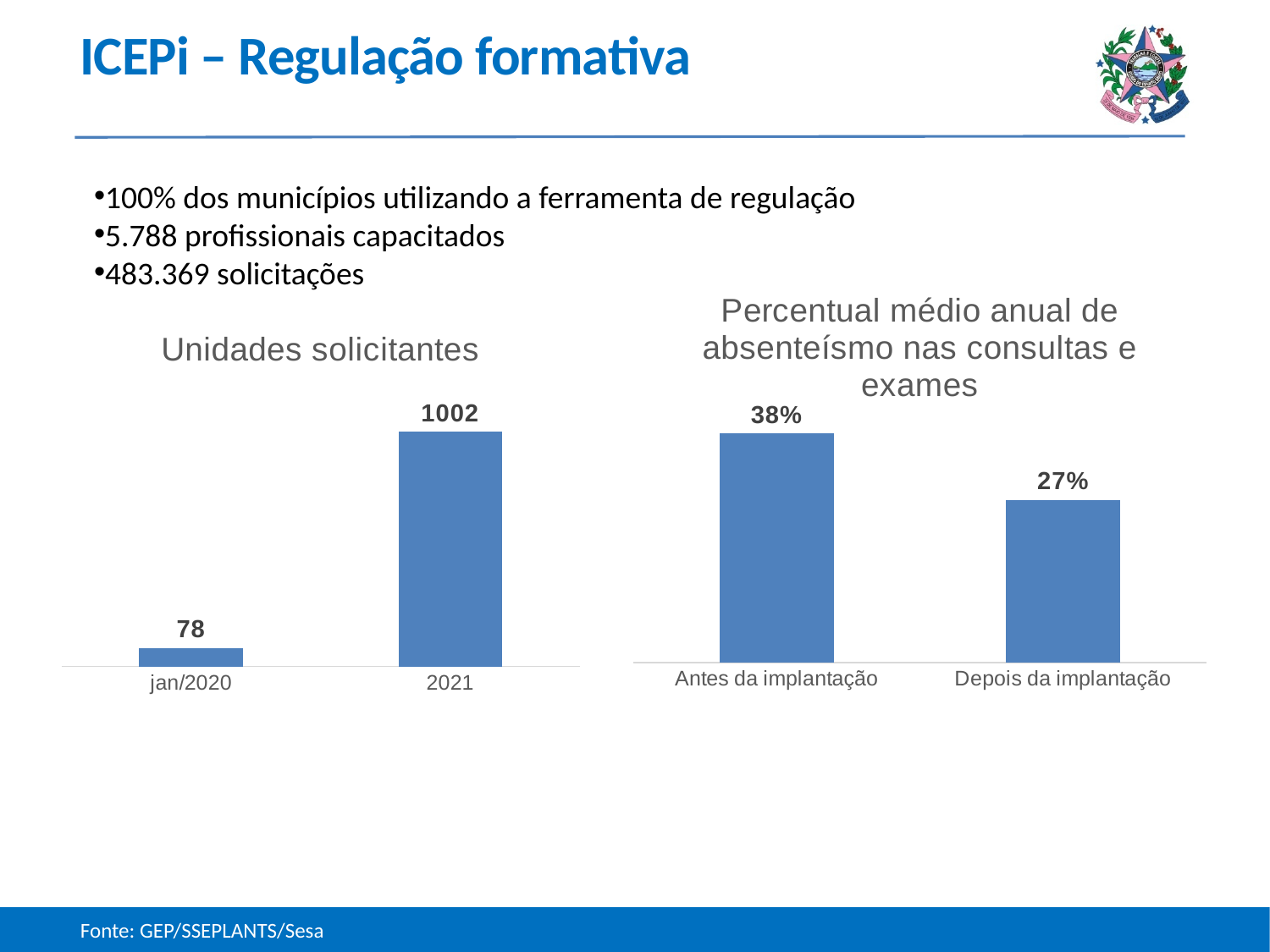
In the 'Unidades solicitantes' chart, what is the value for 2021? 1002 In the 'Percentual médio anual de absenteísmo nas consultas e exames' chart, which category has the lowest value? Depois da implantação In the 'Unidades solicitantes' chart, which category has the highest value? 2021 In the 'Percentual médio anual de absenteísmo nas consultas e exames' chart, what is the value for 'Depois da implantação'? 27% In the 'Percentual médio anual de absenteísmo nas consultas e exames' chart, what is the value for 'Antes da implantação'? 38% In the 'Unidades solicitantes' chart, what is the difference between the 2021 value and the jan/2020 value? 924 In the 'Percentual médio anual de absenteísmo nas consultas e exames' chart, by how many percentage points does 'Antes da implantação' exceed 'Depois da implantação'? 11 percentage points In the 'Unidades solicitantes' chart, how many categories are shown? 2 In the 'Unidades solicitantes' chart, do the values rise or fall from jan/2020 to 2021? rise What is the title of the chart on the left of the slide? Unidades solicitantes What kind of chart is the chart on the right of the slide? bar chart In the 'Unidades solicitantes' chart, what is the value for jan/2020? 78